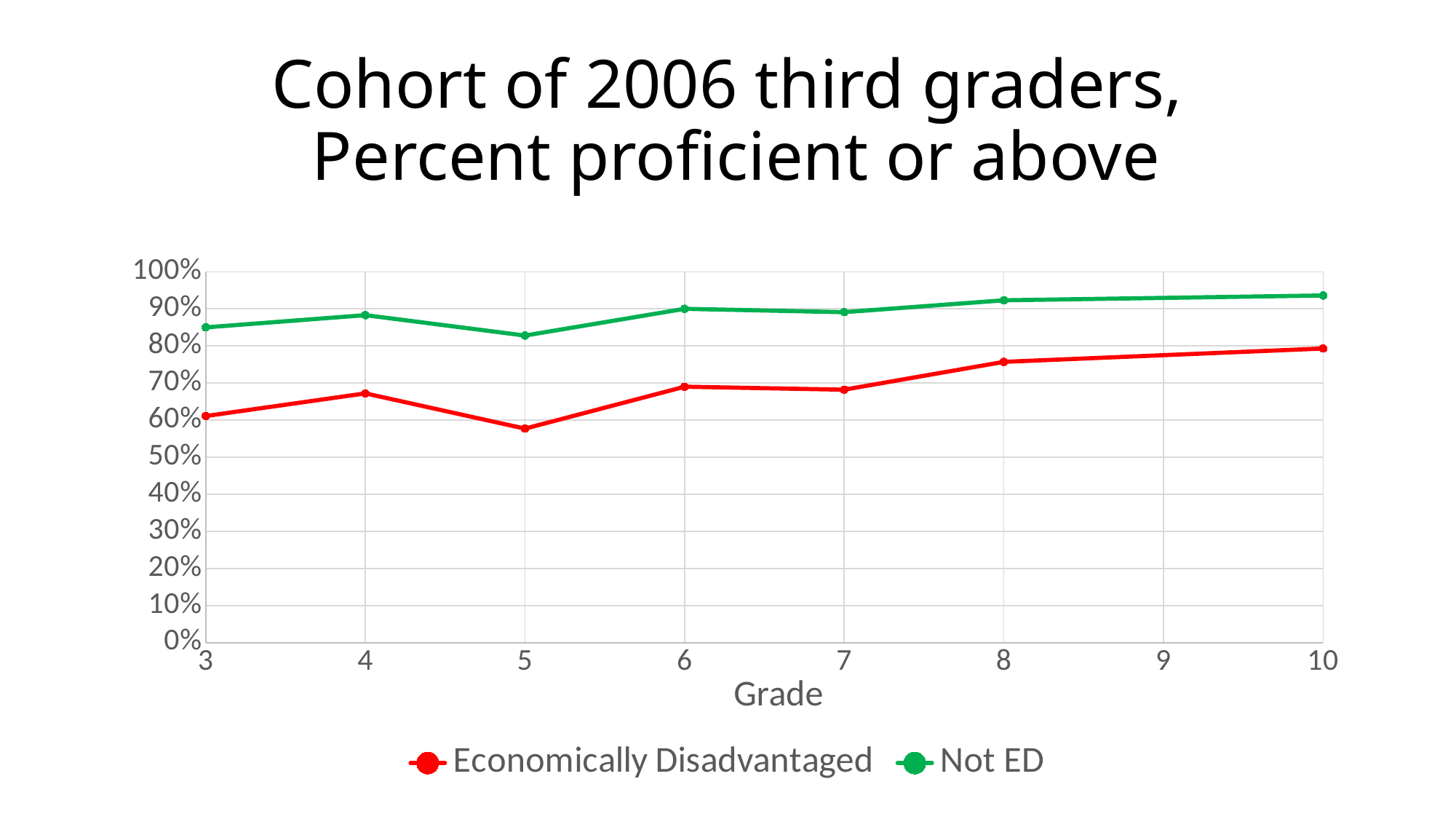
Is the Not ED value at grade 3 greater or less than 90%? less At which grade is the Not ED series lowest? 5 At which grade is the Economically Disadvantaged series lowest? 5 Is the Not ED value at grade 5 greater or less than 80%? greater Is the Economically Disadvantaged value at grade 8 greater or less than 70%? greater How many grade points are plotted for the Economically Disadvantaged series? 7 What type of chart is shown on the slide? line chart At grade 6, which series has the higher value, Economically Disadvantaged or Not ED? Not ED Overall, does the Not ED series rise or fall from grade 3 to grade 10? rise What colour is the line for the Economically Disadvantaged series? red How many series does the legend list? 2 At which grade is the Economically Disadvantaged series highest? 10